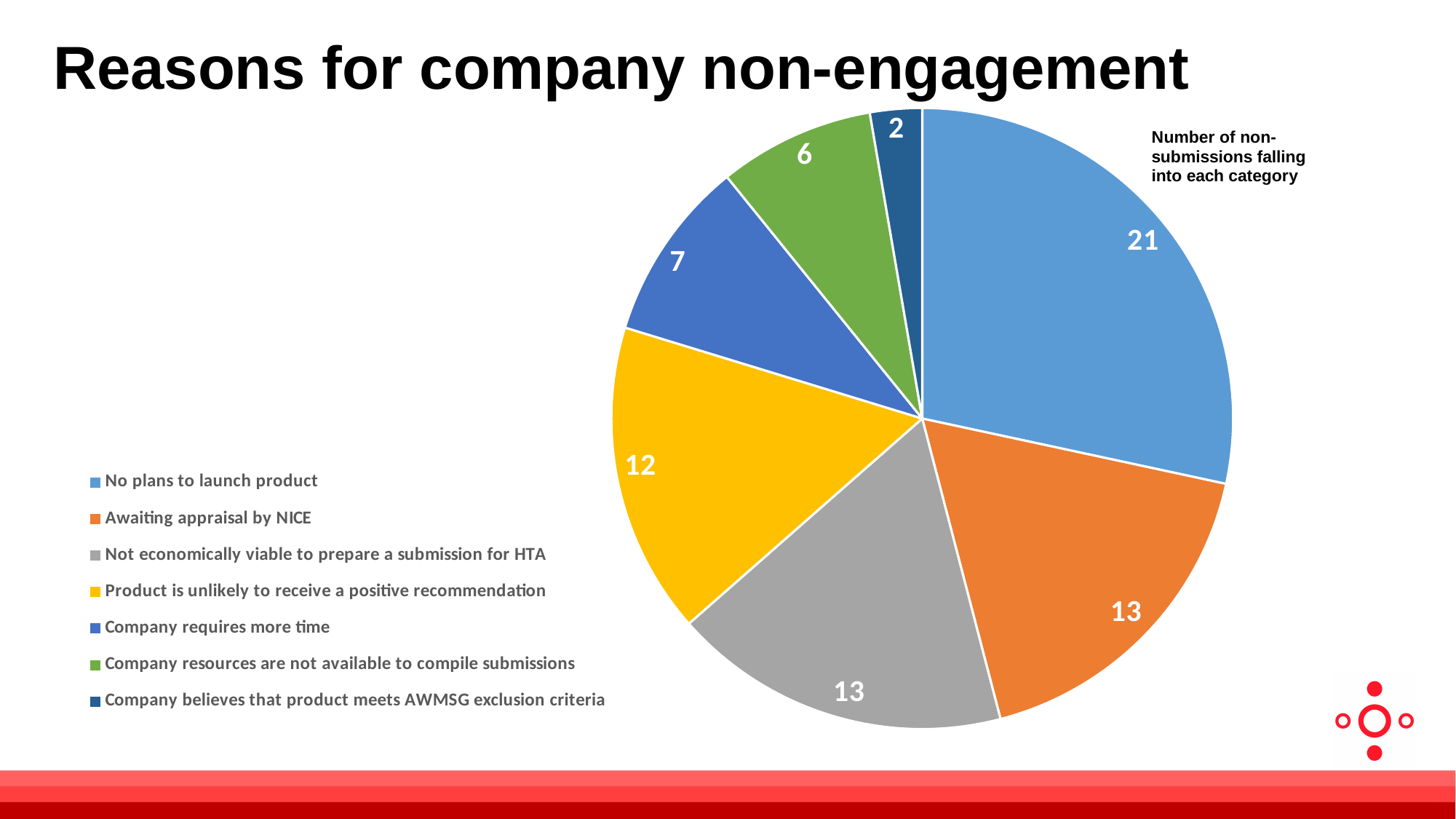
What kind of chart is shown on the slide? pie chart How many categories does the pie chart have? 7 Which category has the smallest number of non-submissions? Company believes that product meets AWMSG exclusion criteria Which is larger: 'Company requires more time' or 'Company resources are not available to compile submissions'? Company requires more time What is the difference between the values for 'No plans to launch product' and 'Awaiting appraisal by NICE'? 8 What is the total number of non-submissions across all categories? 74 How many non-submissions fall into the 'No plans to launch product' category? 21 What is the value for 'Product is unlikely to receive a positive recommendation'? 12 What is the value for 'Company believes that product meets AWMSG exclusion criteria'? 2 Which category has the largest number of non-submissions? No plans to launch product What is the value for 'Company requires more time'? 7 What colour is the slice for 'Awaiting appraisal by NICE'? orange